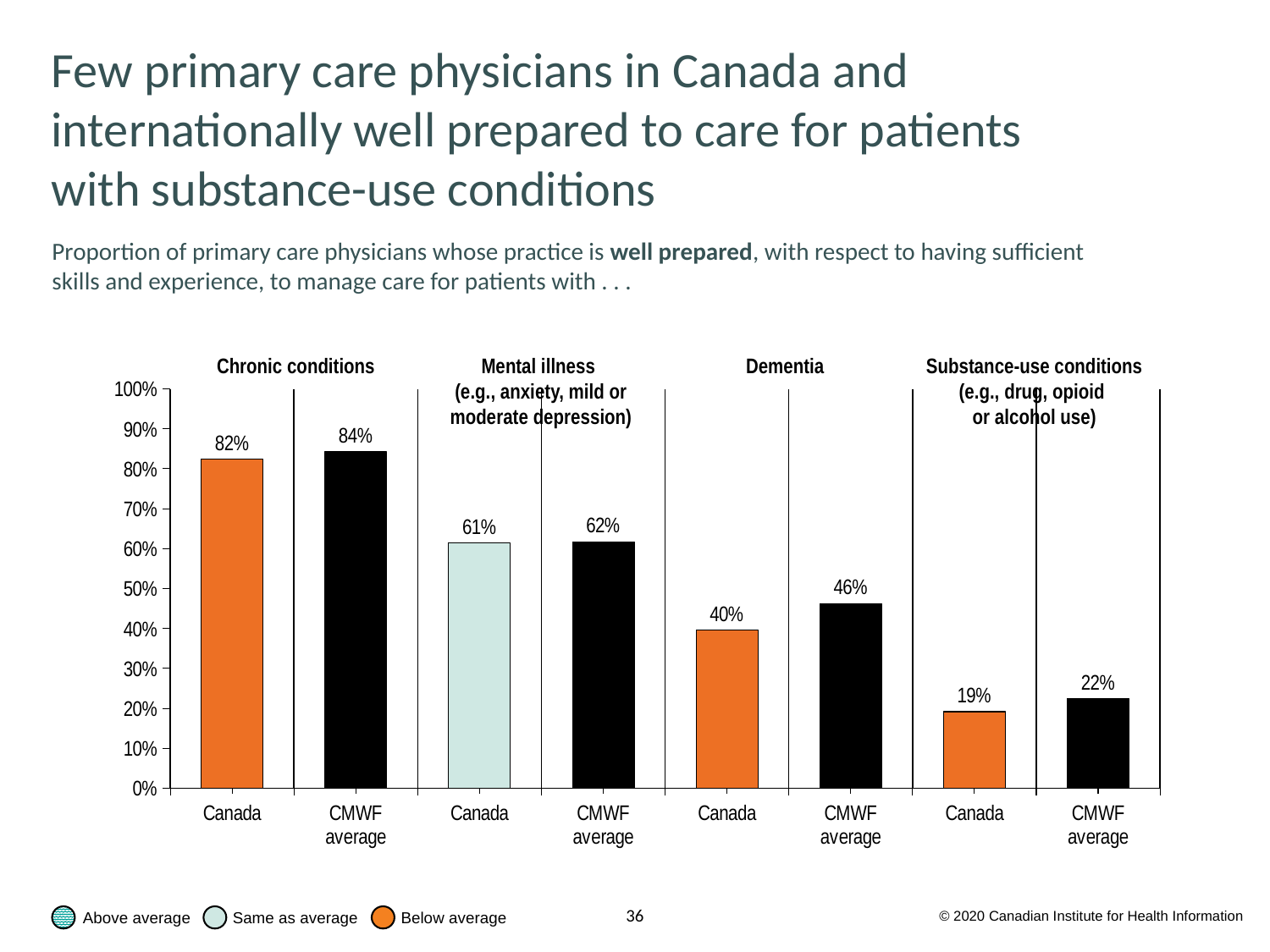
What is the CMWF average for Substance-use conditions? 22% Is the value for Canada under Mental illness greater or less than 50%? greater Which condition group has the lowest CMWF average? Substance-use conditions What is the value for Canada under Dementia? 40% What is the value for Canada under Chronic conditions? 82% What colour is the Canada bar for Mental illness, and what does that colour indicate according to the legend? Light teal; Same as average How many bars are plotted in the chart? 8 What is the CMWF average for Mental illness? 62% What is the difference between the CMWF average and Canada for Dementia? 6% What kind of chart is shown on the slide? Bar chart Which condition group has the highest value for Canada? Chronic conditions Which is larger for Substance-use conditions: Canada or the CMWF average? CMWF average